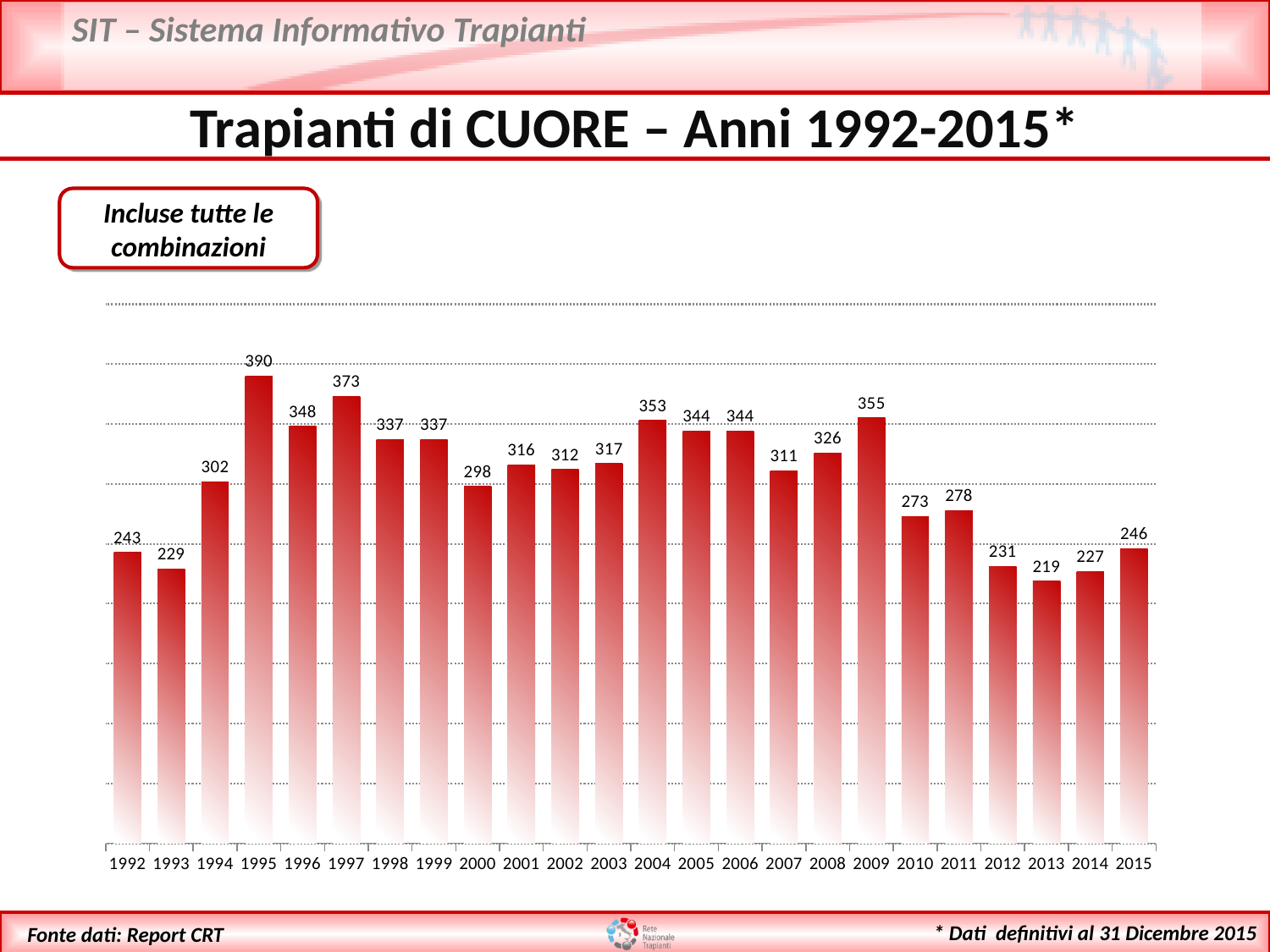
How many heart transplants were performed in 1995? 390 What is the value shown for 2009? 355 What is the difference between the values for 1995 and 2013? 171 Do the values rise or fall from 2009 to 2013? Fall Which year has the lowest number of heart transplants? 2013 What is the value shown for 2015? 246 What is the difference between the values for 2009 and 2010? 82 Which year has a larger value, 1997 or 2004? 1997 How many years are shown on the x axis? 24 What kind of chart is shown on the slide? Bar chart Which year has the highest number of heart transplants? 1995 Which year has a larger value, 1992 or 2012? 1992